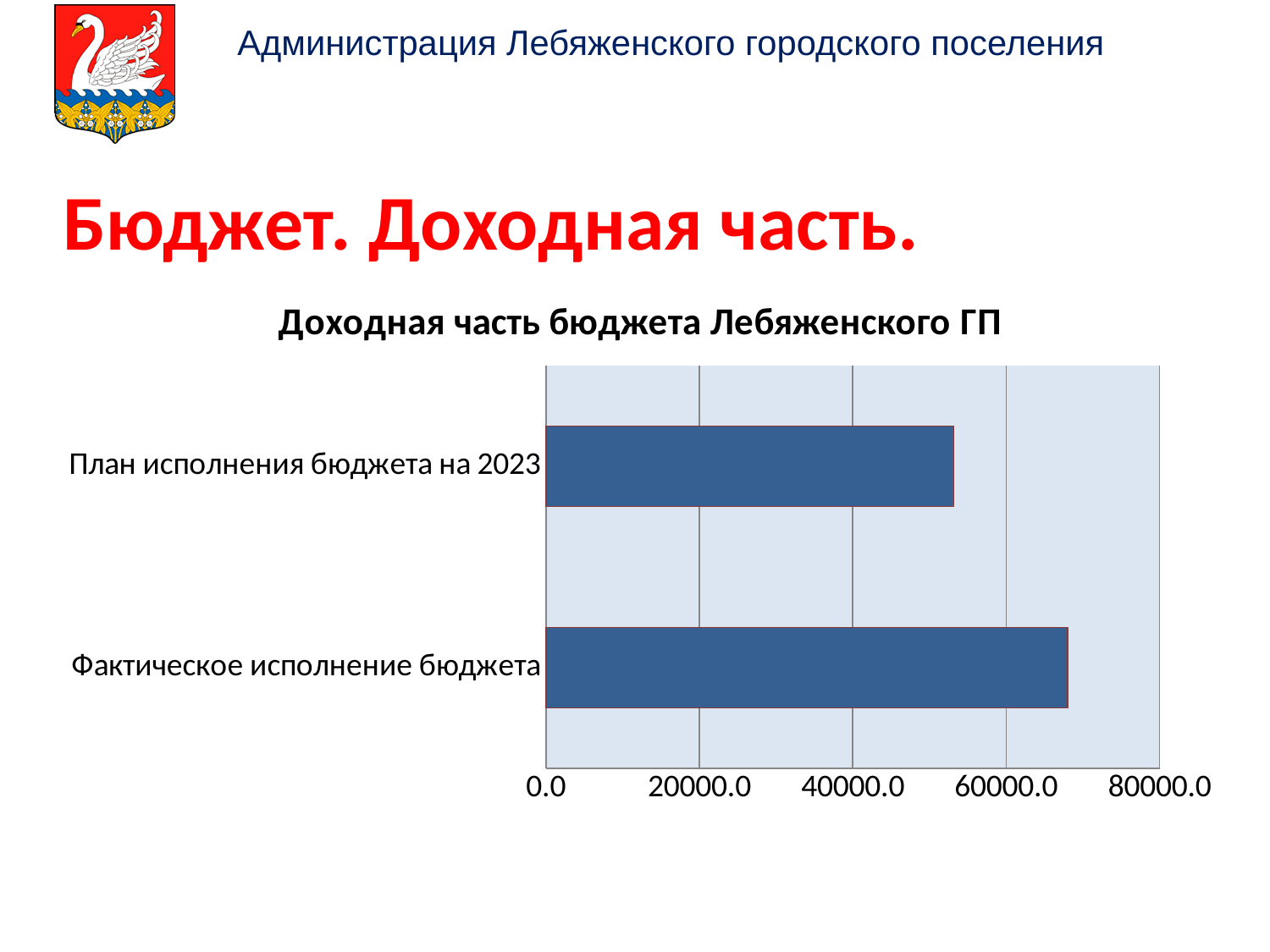
How many categories are plotted in the chart? 2 Which category has the lowest value in the chart? План исполнения бюджета на 2023 Is the value for План исполнения бюджета на 2023 greater or less than 40000.0? greater Is the value for Фактическое исполнение бюджета greater or less than 60000.0? greater Is the value for План исполнения бюджета на 2023 greater or less than 60000.0? less What kind of chart is shown on the slide? bar chart Which category has the highest value in the chart? Фактическое исполнение бюджета What is the highest value shown on the x axis of the chart? 80000.0 Which is larger: the value for План исполнения бюджета на 2023 or the value for Фактическое исполнение бюджета? Фактическое исполнение бюджета What is the title of the chart? Доходная часть бюджета Лебяженского ГП